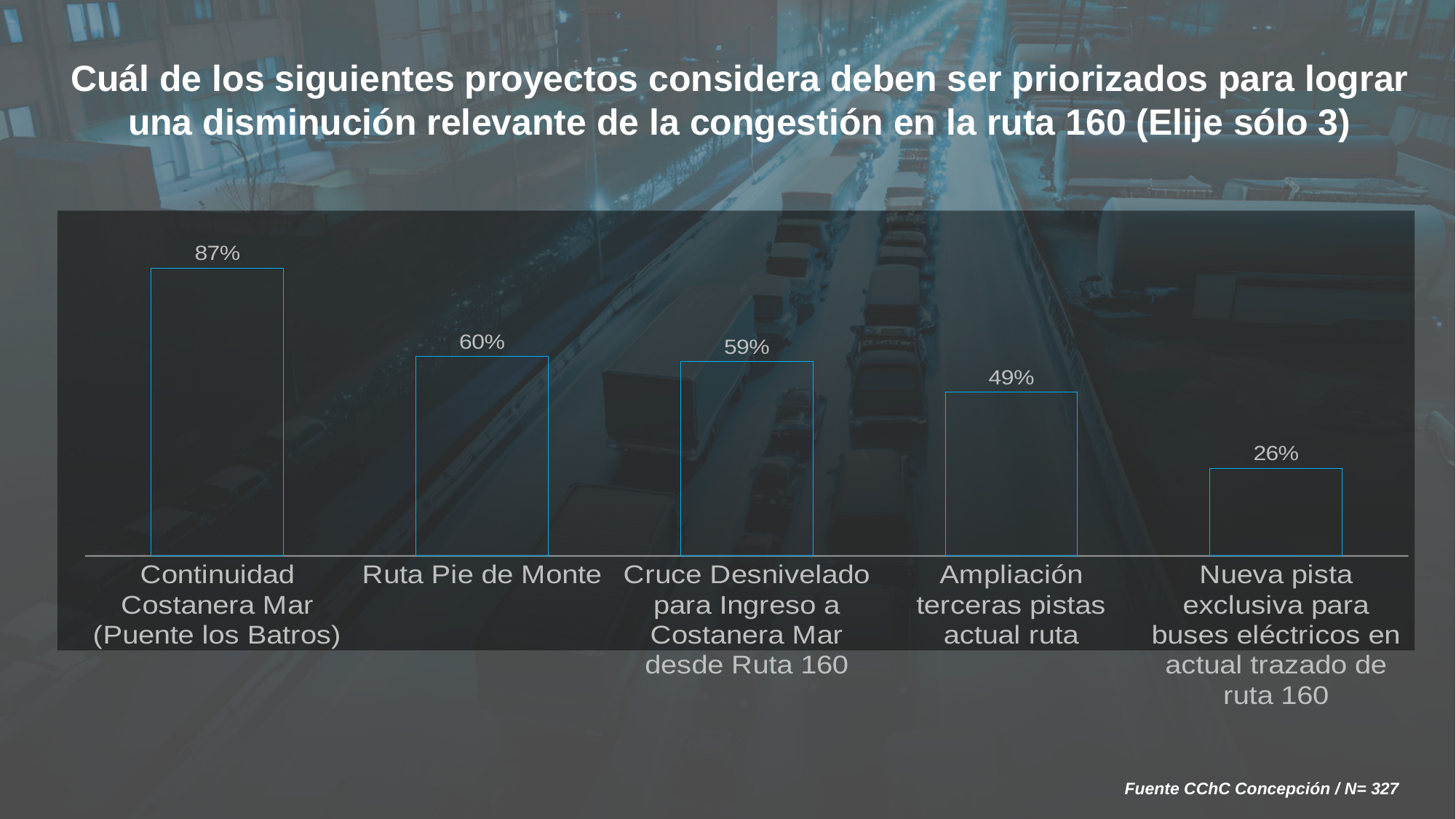
What is the value for Ruta Pie de Monte? 60% What is the value for Cruce Desnivelado para Ingreso a Costanera Mar desde Ruta 160? 59% What kind of chart is shown on the slide? Bar chart Which is larger: the value for Ruta Pie de Monte or the value for Ampliación terceras pistas actual ruta? Ruta Pie de Monte What is the value for Continuidad Costanera Mar (Puente los Batros)? 87% What is the difference between the values for Ampliación terceras pistas actual ruta and Nueva pista exclusiva para buses eléctricos en actual trazado de ruta 160? 23% What is the value for Nueva pista exclusiva para buses eléctricos en actual trazado de ruta 160? 26% Which project has the highest value? Continuidad Costanera Mar (Puente los Batros) How many projects are shown in the chart? 5 What is the difference between the values for Continuidad Costanera Mar (Puente los Batros) and Ruta Pie de Monte? 27% Which project has the lowest value? Nueva pista exclusiva para buses eléctricos en actual trazado de ruta 160 What is the value for Ampliación terceras pistas actual ruta? 49%